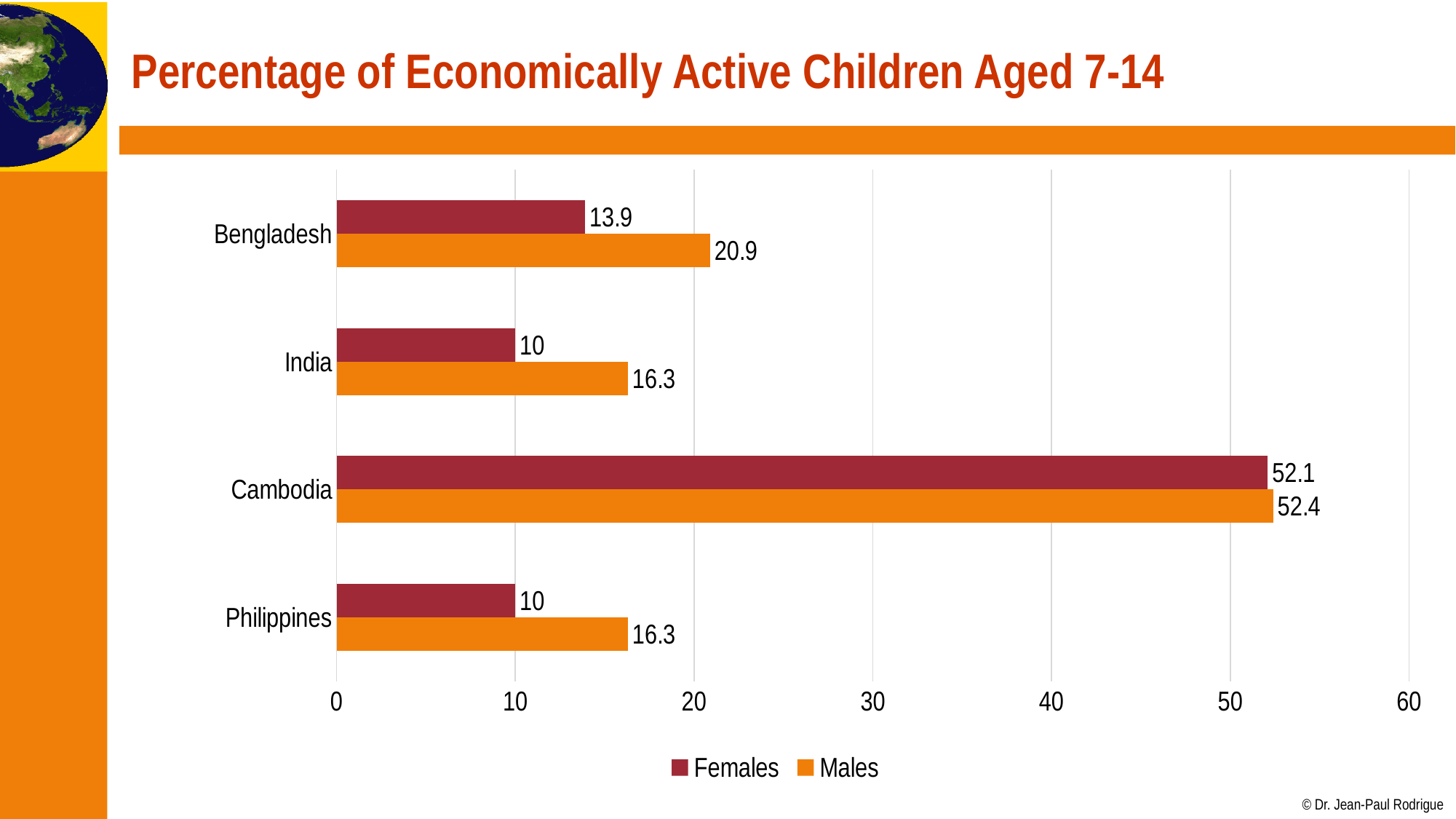
What is the Males value for Cambodia? 52.4 Is the Females value for Cambodia greater or less than 50? greater Which country has the lowest Males value? India and Philippines (tie at 16.3) Which is larger: the Females value for Bengladesh or the Females value for India? Bengladesh How many series does the legend list? 2 What is the Females value for Philippines? 10 What is the difference between the Males and Females values for Bengladesh? 7 Which country has the highest Males value? Cambodia How many countries are shown on the chart? 4 What is the Males value for India? 16.3 What kind of chart is shown on the slide? bar chart What is the Females value for Bengladesh? 13.9